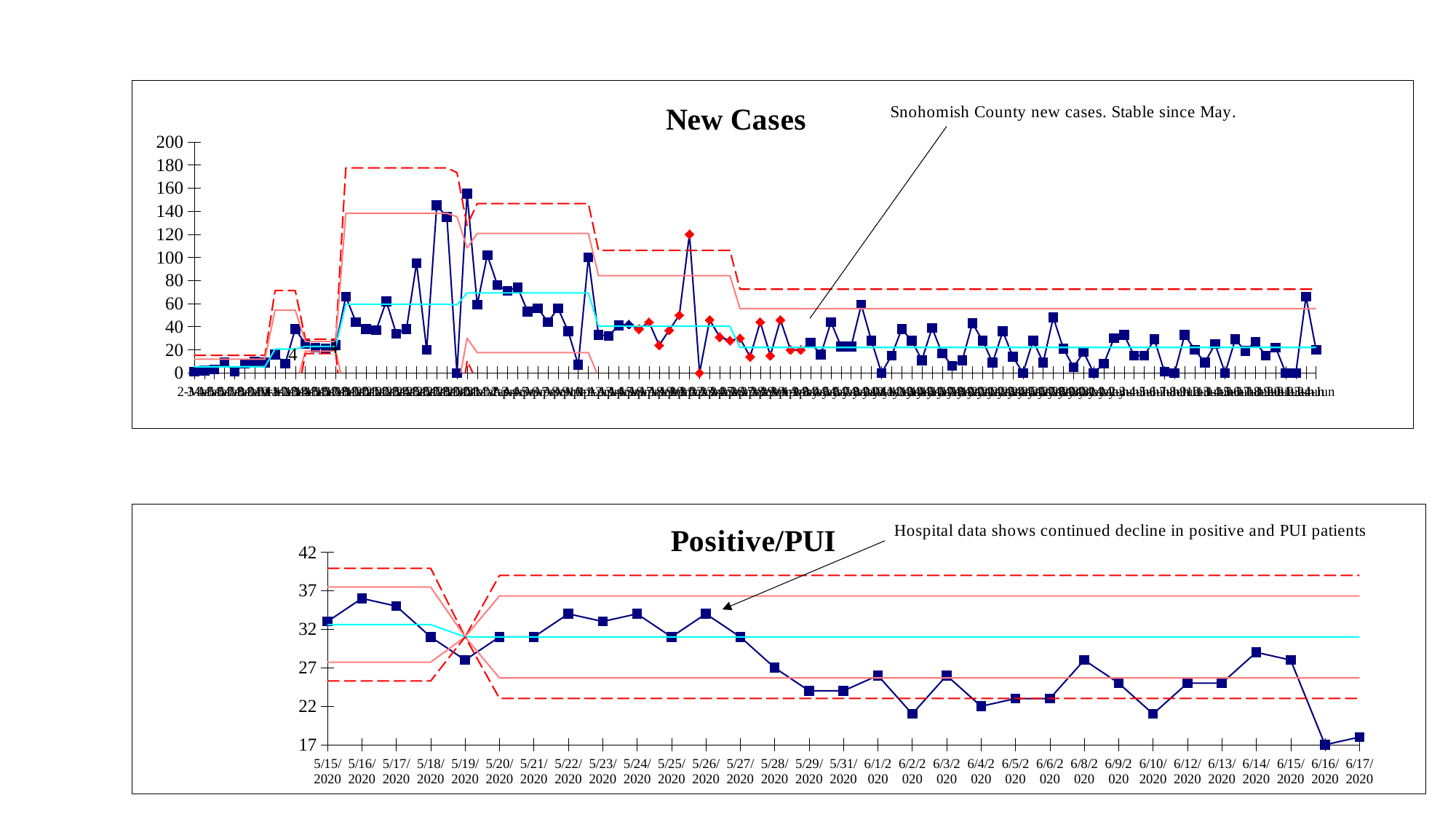
In the Positive/PUI chart, which date has the lowest value? 6/16/2020 In the Positive/PUI chart, is the value for 6/17/2020 greater or less than 22? less What is the title of the top chart on the slide? New Cases What kind of chart is the New Cases chart at the top of the slide? line chart In the Positive/PUI chart, how many dates are plotted along the x axis? 31 In the Positive/PUI chart, do the values generally rise or fall from 5/15/2020 to 6/17/2020? fall In the Positive/PUI chart, which is larger, the value for 5/16/2020 or the value for 6/16/2020? 5/16/2020 In the Positive/PUI chart, is the value for 6/16/2020 greater or less than 22? less In the Positive/PUI chart, is the value for 5/22/2020 greater or less than 32? greater What kind of chart is the Positive/PUI chart at the bottom of the slide? line chart